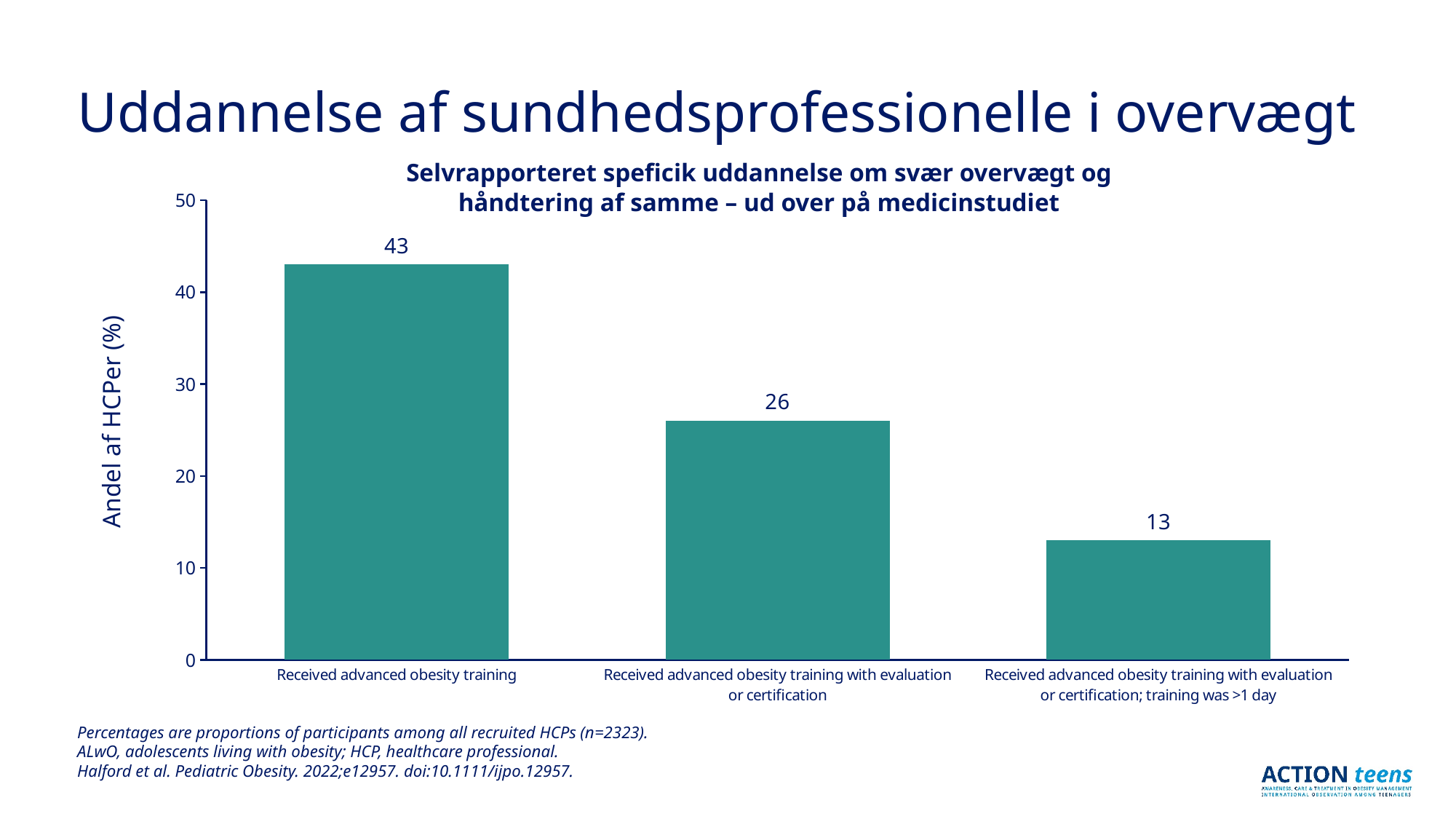
What kind of chart is shown on the slide? Bar chart What is the difference between the values for 'Received advanced obesity training with evaluation or certification' and 'Received advanced obesity training with evaluation or certification; training was >1 day'? 13 What is the value for 'Received advanced obesity training with evaluation or certification'? 26 What is the value for 'Received advanced obesity training with evaluation or certification; training was >1 day'? 13 What is the label of the y axis? Andel af HCPer (%) What is the difference between the values for 'Received advanced obesity training' and 'Received advanced obesity training with evaluation or certification'? 17 How many categories are shown in the chart? 3 Which category has the highest value? Received advanced obesity training What is the value for 'Received advanced obesity training'? 43 Is the value for 'Received advanced obesity training' greater or less than 40? greater Which category has the lowest value? Received advanced obesity training with evaluation or certification; training was >1 day Which is larger: the value for 'Received advanced obesity training with evaluation or certification' or the value for 'Received advanced obesity training with evaluation or certification; training was >1 day'? Received advanced obesity training with evaluation or certification